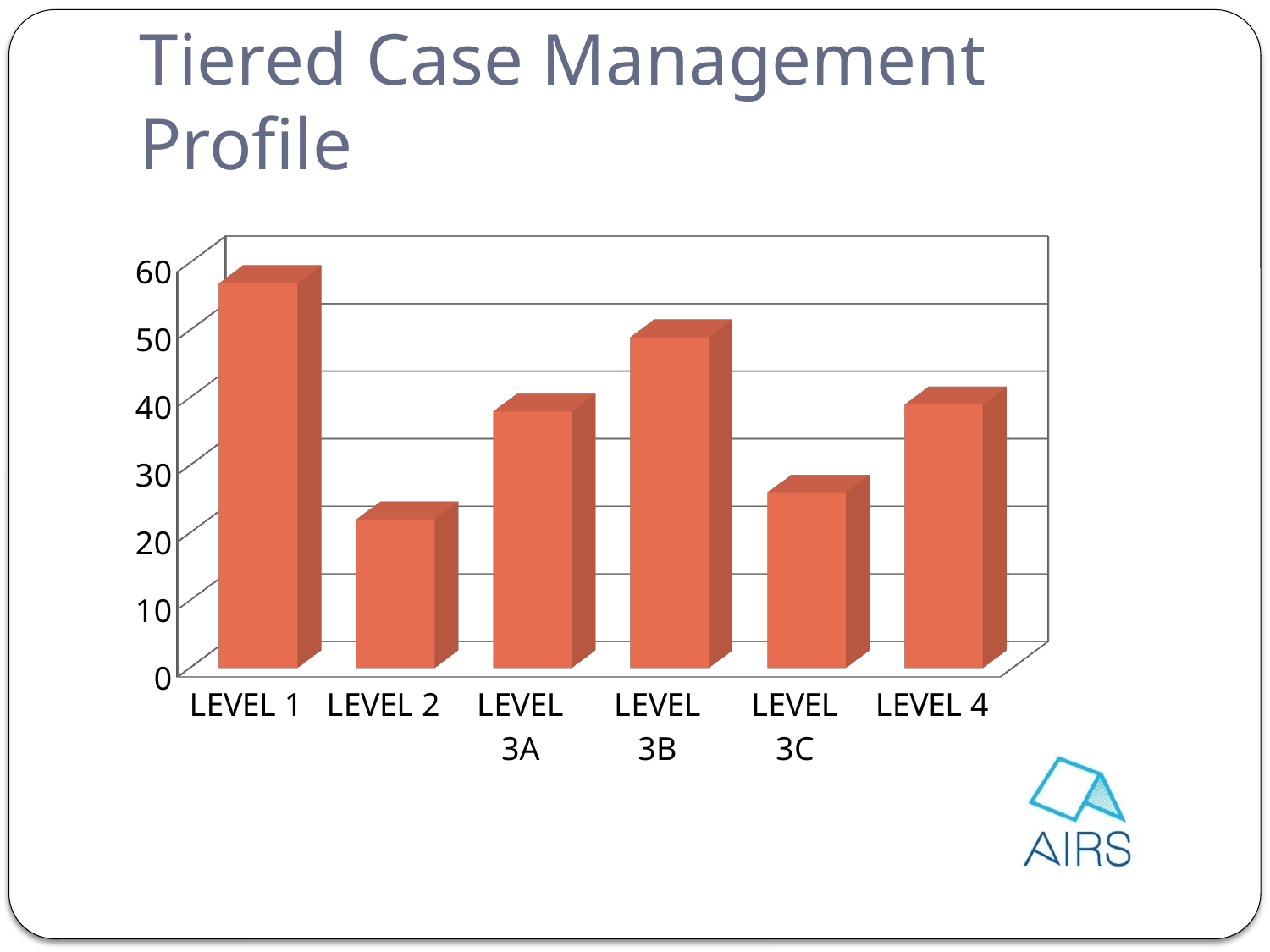
Is the value for LEVEL 3C greater or less than 30? less Is the value for LEVEL 4 greater or less than 50? less What is the title of the slide containing the chart? Tiered Case Management Profile Which level has the highest bar in the chart? LEVEL 1 How many categories (levels) are shown on the x axis of the chart? 6 Which is larger, the value for LEVEL 3B or the value for LEVEL 3C? LEVEL 3B Is the value for LEVEL 2 greater or less than 30? less Which level has the lowest bar in the chart? LEVEL 2 What kind of chart is shown on the slide? Bar chart Which is larger, the value for LEVEL 2 or the value for LEVEL 4? LEVEL 4